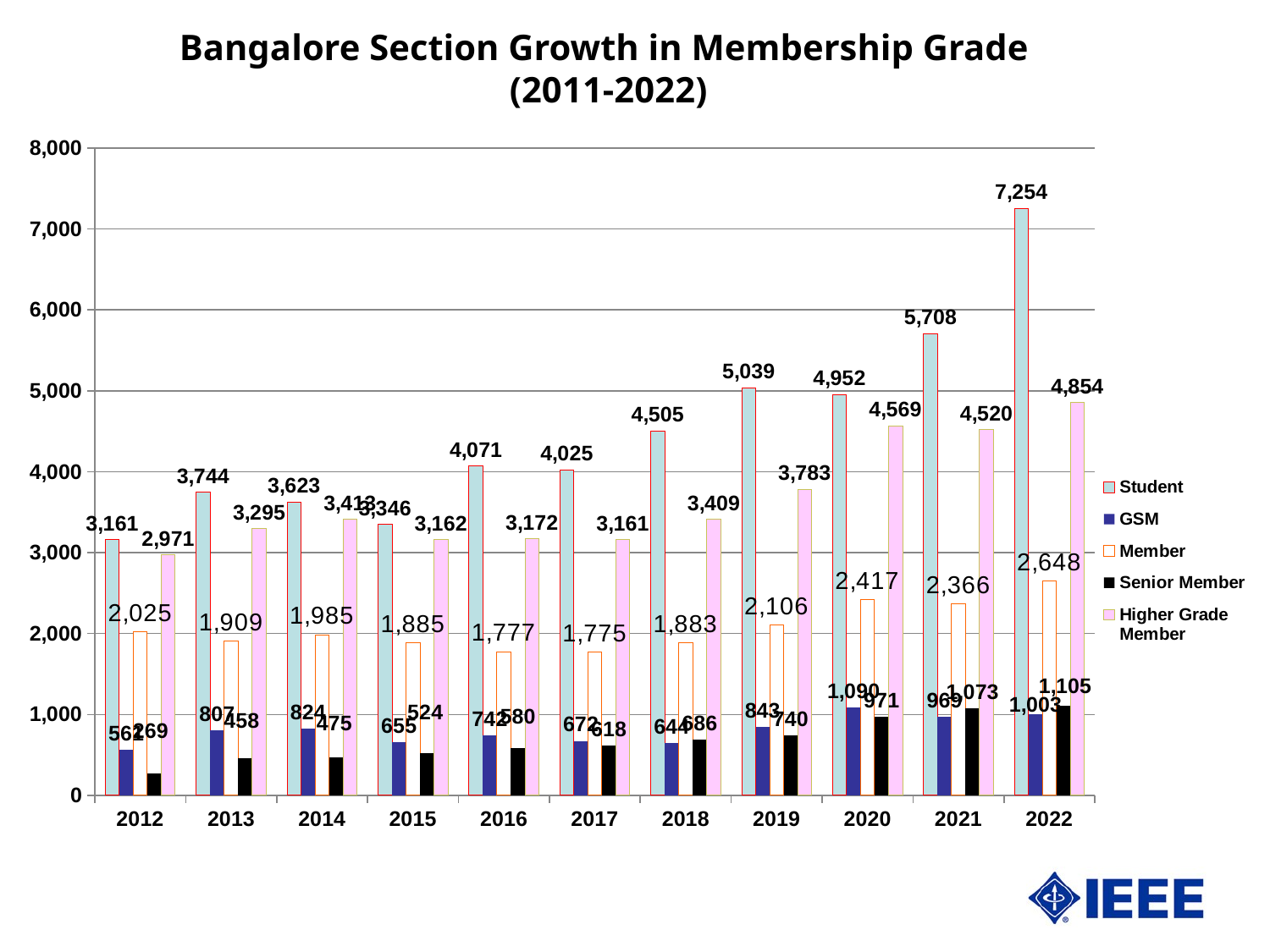
In which year is the Senior Member value lowest? 2012 What is the difference between the Student values for 2022 and 2021? 1,546 What is the Higher Grade Member value for 2022? 4,854 In which year is the Student membership highest? 2022 What kind of chart is shown on the slide? bar chart How many years are shown on the x axis? 11 Is the Senior Member value for 2020 greater or less than 1,000? less What is the Student membership value for 2022? 7,254 What is the Member value for 2020? 2,417 Which year has the larger Student value, 2019 or 2020? 2019 How many series does the legend list? 5 Does the Senior Member value rise or fall from 2012 to 2022? rise